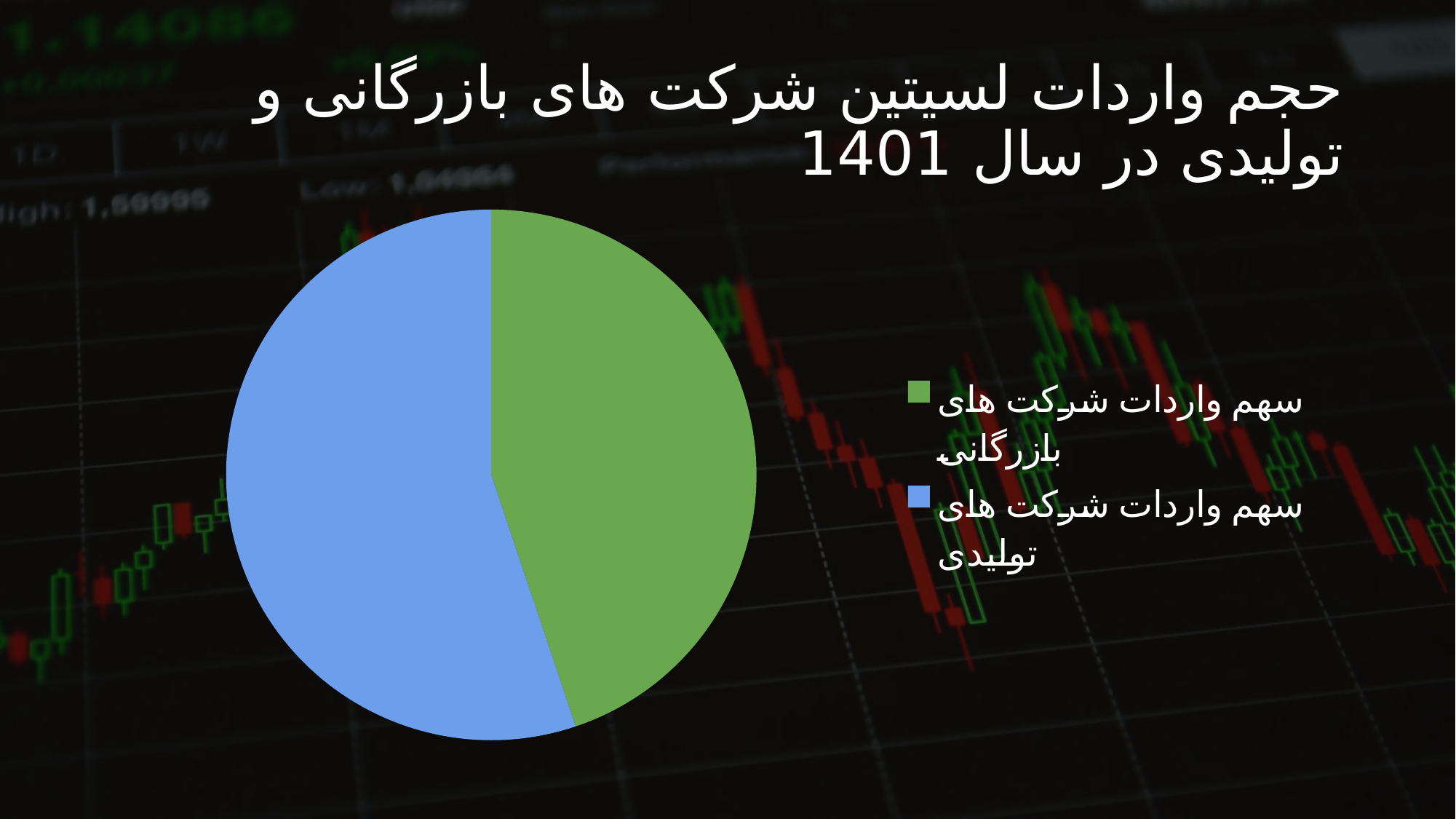
How many entries does the legend list? 2 What colour is the slice for سهم واردات شرکت های تولیدی? Blue How many slices does the pie chart have? 2 Which category has the smallest slice of the pie? سهم واردات شرکت های بازرگانی Which slice is larger: سهم واردات شرکت های بازرگانی or سهم واردات شرکت های تولیدی? سهم واردات شرکت های تولیدی What is the title of the slide containing the pie chart? حجم واردات لسیتین شرکت های بازرگانی و تولیدی در سال 1401 What kind of chart is shown on the slide? Pie chart Which category has the largest slice of the pie? سهم واردات شرکت های تولیدی